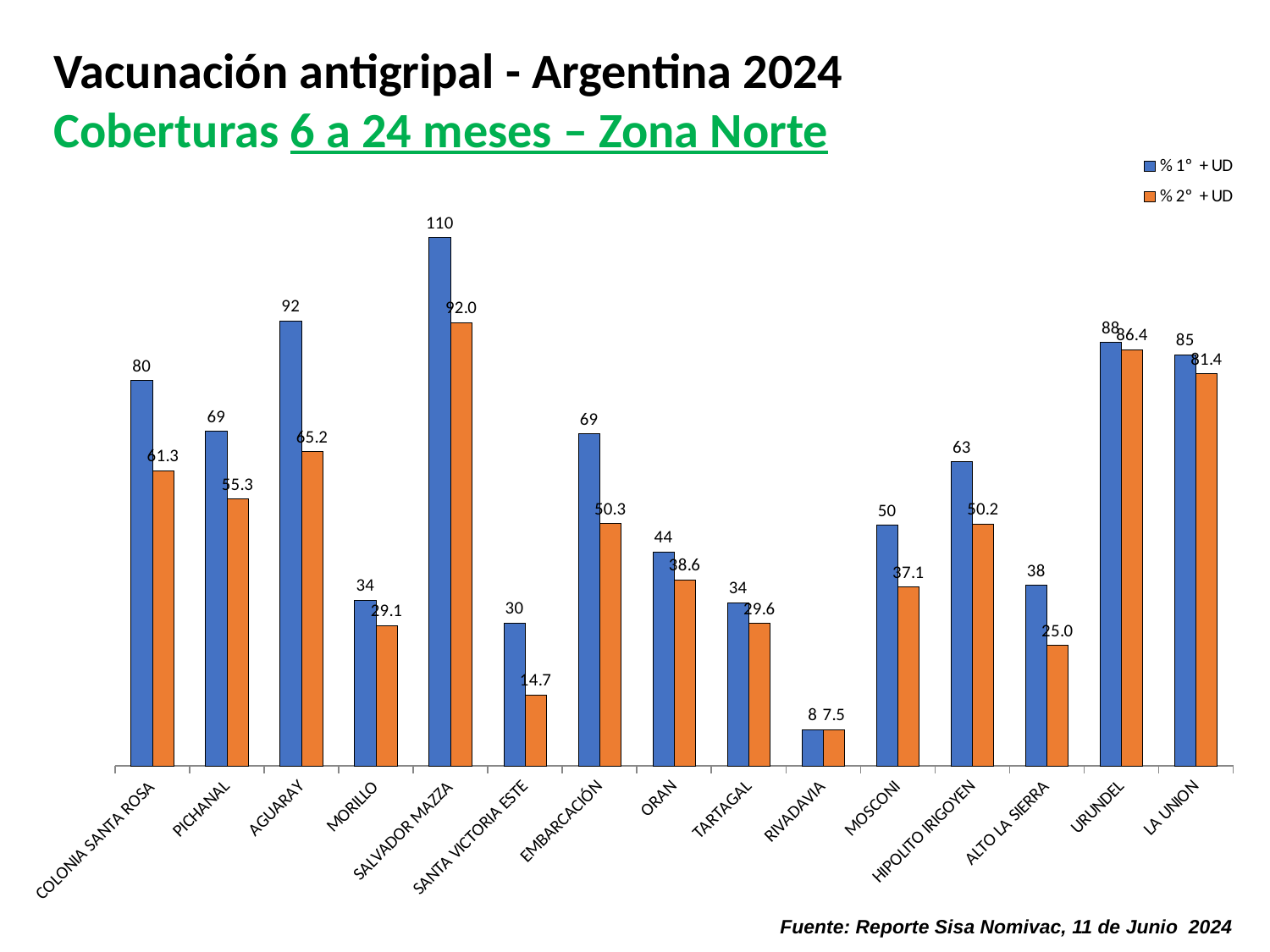
Which is larger: the % 1° + UD value for AGUARAY or the % 1° + UD value for LA UNION? AGUARAY Which locality has the lowest % 2° + UD value? RIVADAVIA Which colour represents the % 2° + UD series? Orange What is the % 1° + UD value for HIPOLITO IRIGOYEN? 63 What is the % 1° + UD value for SALVADOR MAZZA? 110 How many localities are shown on the x axis? 15 Which locality has the highest % 1° + UD value? SALVADOR MAZZA What is the difference between the % 1° + UD and % 2° + UD values for COLONIA SANTA ROSA? 18.7 How many series does the legend list? 2 What is the % 2° + UD value for URUNDEL? 86.4 What is the % 2° + UD value for SANTA VICTORIA ESTE? 14.7 What kind of chart is shown on the slide? Bar chart